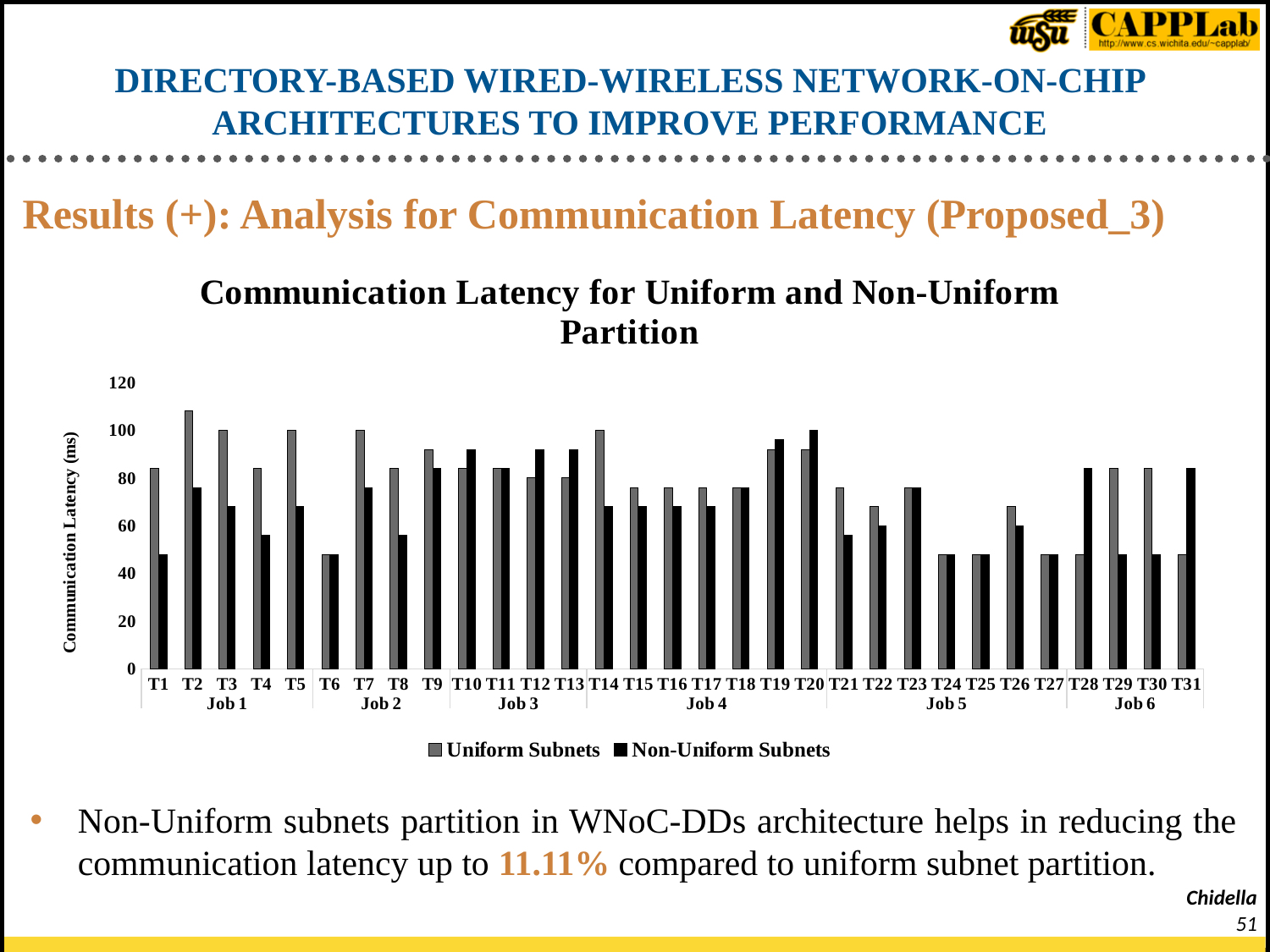
What kind of chart is shown on the slide? bar chart Which task has the highest Uniform Subnets communication latency? T2 Is the Uniform Subnets value for T2 greater or less than 100? greater What is the Uniform Subnets communication latency for T3? 100 How many series does the legend list? 2 Is the Non-Uniform Subnets value for T19 greater or less than 80? greater How many tasks (T1 to T31) are shown along the x axis? 31 Is the Non-Uniform Subnets value for T1 greater or less than 60? less For T1, which is larger: the Uniform Subnets value or the Non-Uniform Subnets value? Uniform Subnets What is the label of the y axis? Communication Latency (ms) How many jobs are the tasks grouped into on the x axis? 6 For T28, which is larger: the Uniform Subnets value or the Non-Uniform Subnets value? Non-Uniform Subnets